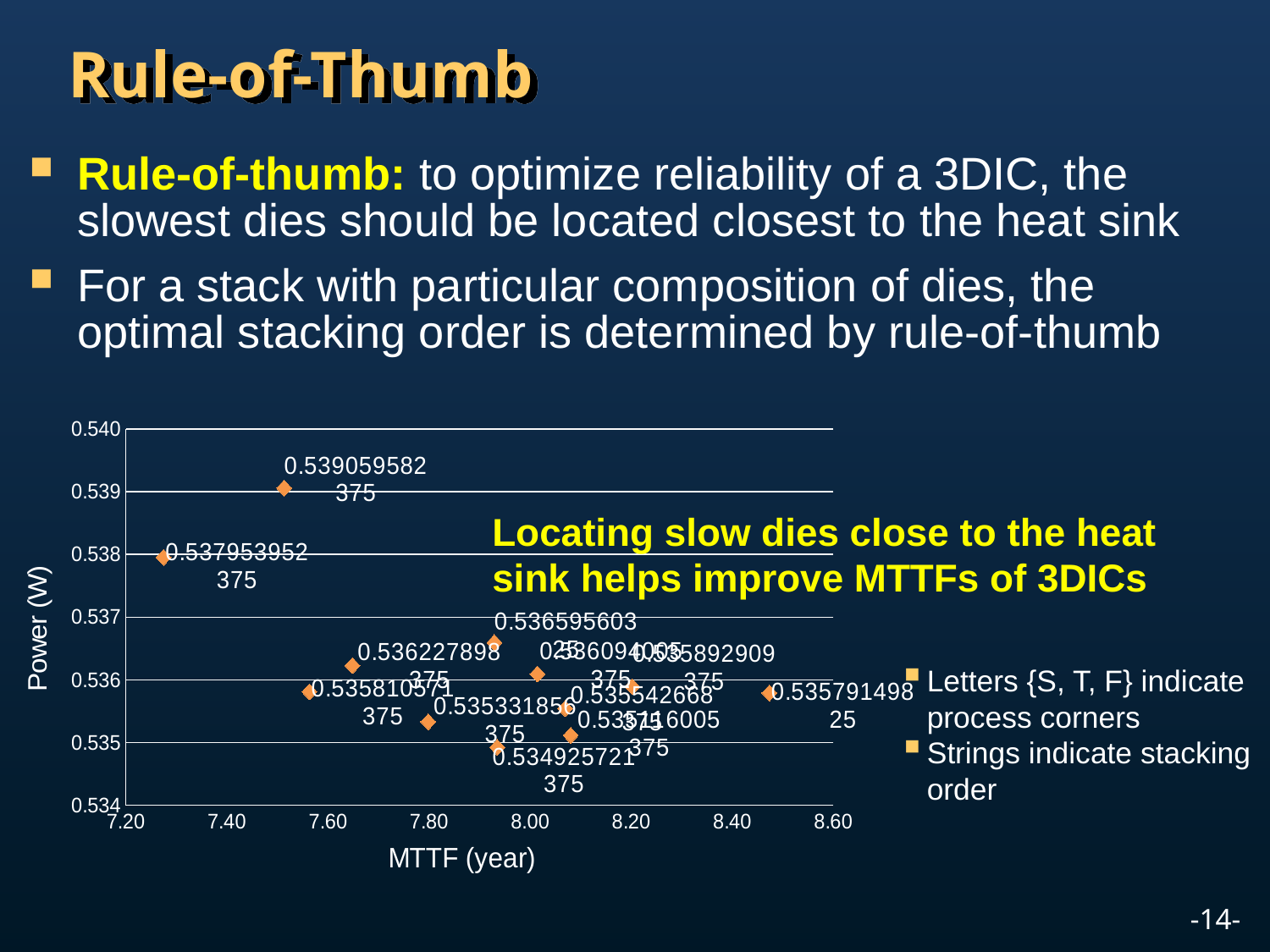
Which point has higher power: the one near MTTF 7.27 years or the one near MTTF 7.51 years? the one near MTTF 7.51 years Is the power of the lowest point on the chart greater or less than 0.535? less Is the power of the highest point on the chart greater or less than 0.539? greater Is the power of the rightmost point on the chart (near MTTF 8.47 years) greater or less than 0.536? less What kind of chart is shown on the slide? scatter chart What is the lowest power value labelled on the chart? 0.534925721 What is the difference in power between the point labelled 0.539059582 and the point labelled 0.537953952? 0.00110563 What is the title of the x axis of the chart? MTTF (year) What is the highest power value labelled on the chart? 0.539059582 As MTTF increases along the x axis, does power generally rise or fall? fall What is the title of the y axis of the chart? Power (W)